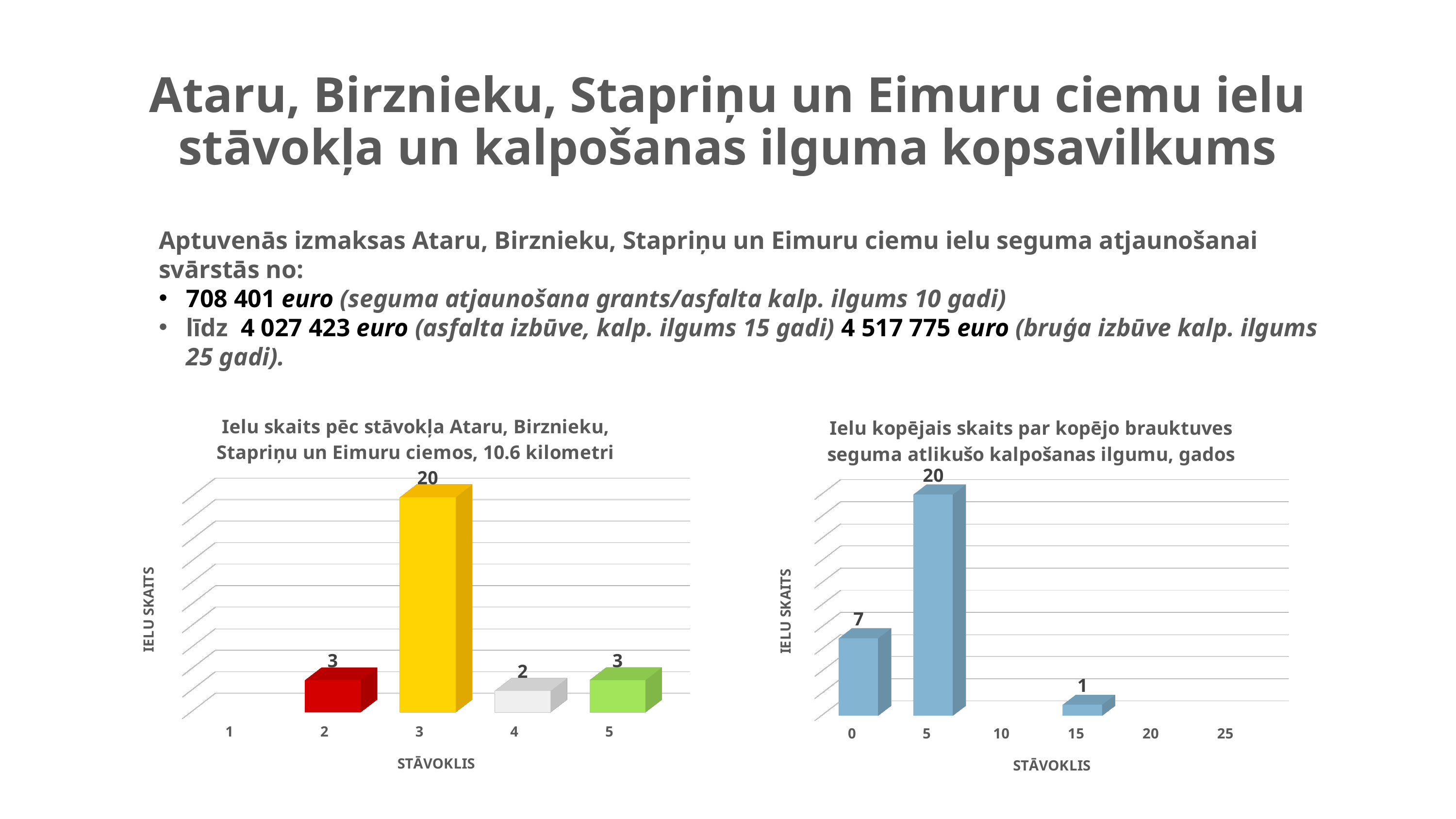
In the left chart (Ielu skaits pēc stāvokļa), what is the value for category 4? 2 In the left chart (Ielu skaits pēc stāvokļa), what is the difference between the values for category 3 and category 2? 17 In the left chart (Ielu skaits pēc stāvokļa), which is larger, the value for category 2 or category 4? category 2 In the right chart (Ielu kopējais skaits), which category has the highest value? 5 In the left chart (Ielu skaits pēc stāvokļa), what is the value for category 3? 20 In the right chart (Ielu kopējais skaits), how many categories are shown on the x axis? 6 In the right chart (Ielu kopējais skaits), what is the difference between the values for category 5 and category 0? 13 In the right chart (Ielu kopējais skaits), what is the value for category 0? 7 In the left chart (Ielu skaits pēc stāvokļa), which category has the highest value? 3 In the right chart (Ielu kopējais skaits), what is the value for category 15? 1 In the left chart (Ielu skaits pēc stāvokļa), how many categories are shown on the x axis? 5 What kind of chart is the right chart (Ielu kopējais skaits)? bar chart